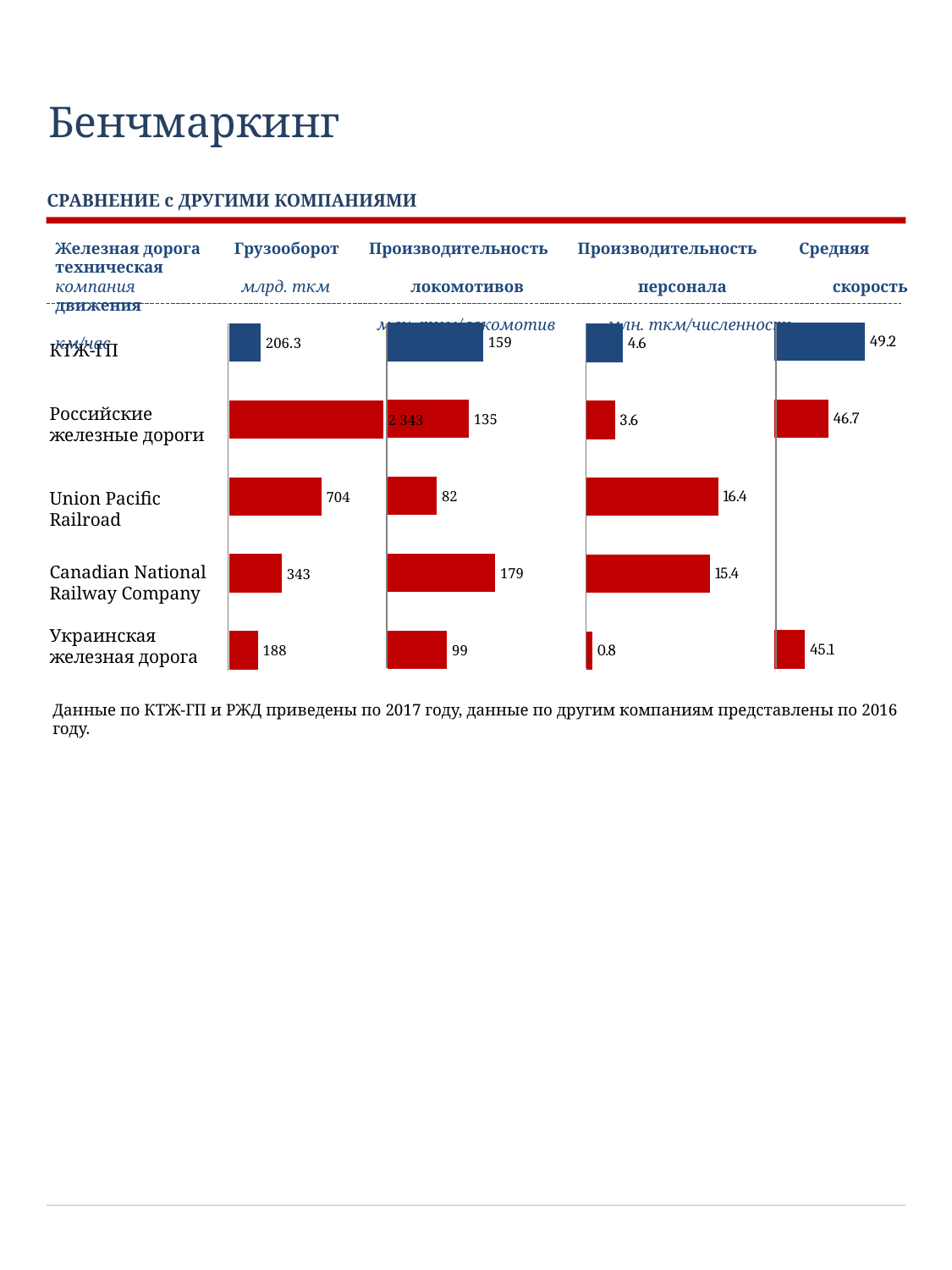
In the Грузооборот chart, which company has the highest value? Российские железные дороги In the Производительность локомотивов chart, which company has the lowest value? Union Pacific Railroad In the Средняя скорость chart, what is the value for Украинская железная дорога? 45.1 In the Производительность локомотивов chart, what is the difference between КТЖ-ГП and Российские железные дороги? 24 In the Средняя скорость chart, what is the difference between КТЖ-ГП and Российские железные дороги? 2.5 How many companies are listed in the Грузооборот chart? 5 In the Производительность персонала chart, which company has the highest value? Union Pacific Railroad In the Грузооборот chart, what is the value for Union Pacific Railroad? 704 In the Производительность персонала chart, what is the value for КТЖ-ГП? 4.6 In the Производительность локомотивов chart, what is the value for Canadian National Railway Company? 179 In the Грузооборот chart, which company has the lowest value? Украинская железная дорога In the Производительность персонала chart, which is larger, Canadian National Railway Company or Российские железные дороги? Canadian National Railway Company